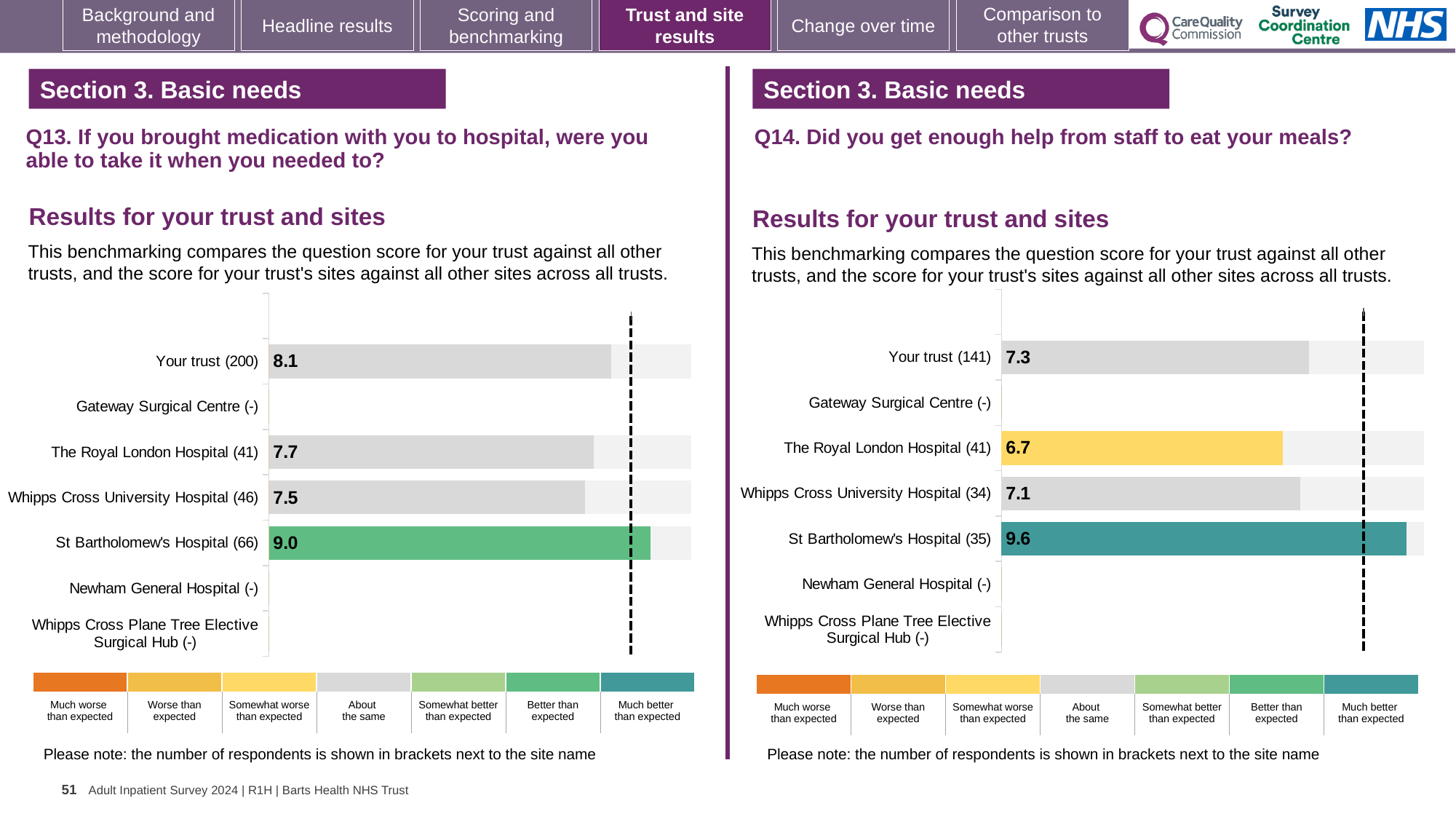
In the Q14 chart on the right, which benchmark category does the colour of The Royal London Hospital (41) bar correspond to in the legend? Somewhat worse than expected In the Q13 chart on the left, what is the difference between the scores for St Bartholomew's Hospital (66) and The Royal London Hospital (41)? 1.3 In the Q14 chart on the right, which site has the highest score? St Bartholomew's Hospital (35) In the Q14 chart on the right, what is the score for The Royal London Hospital (41)? 6.7 In the Q13 chart on the left, how many site or trust labels are listed on the vertical axis? 7 In the Q14 chart on the right, what is the score for Whipps Cross University Hospital (34)? 7.1 In the Q13 chart on the left, what is the score for St Bartholomew's Hospital (66)? 9.0 In the Q14 chart on the right, which is larger: the score for Your trust (141) or for Whipps Cross University Hospital (34)? Your trust (141) In the Q13 chart on the left, which site has the lowest score shown? Whipps Cross University Hospital (46) In the Q14 chart on the right, what is the difference between the scores for St Bartholomew's Hospital (35) and Your trust (141)? 2.3 In the Q13 chart on the left, what is the score for Your trust (200)? 8.1 What type of chart is used on the left for Q13? Bar chart